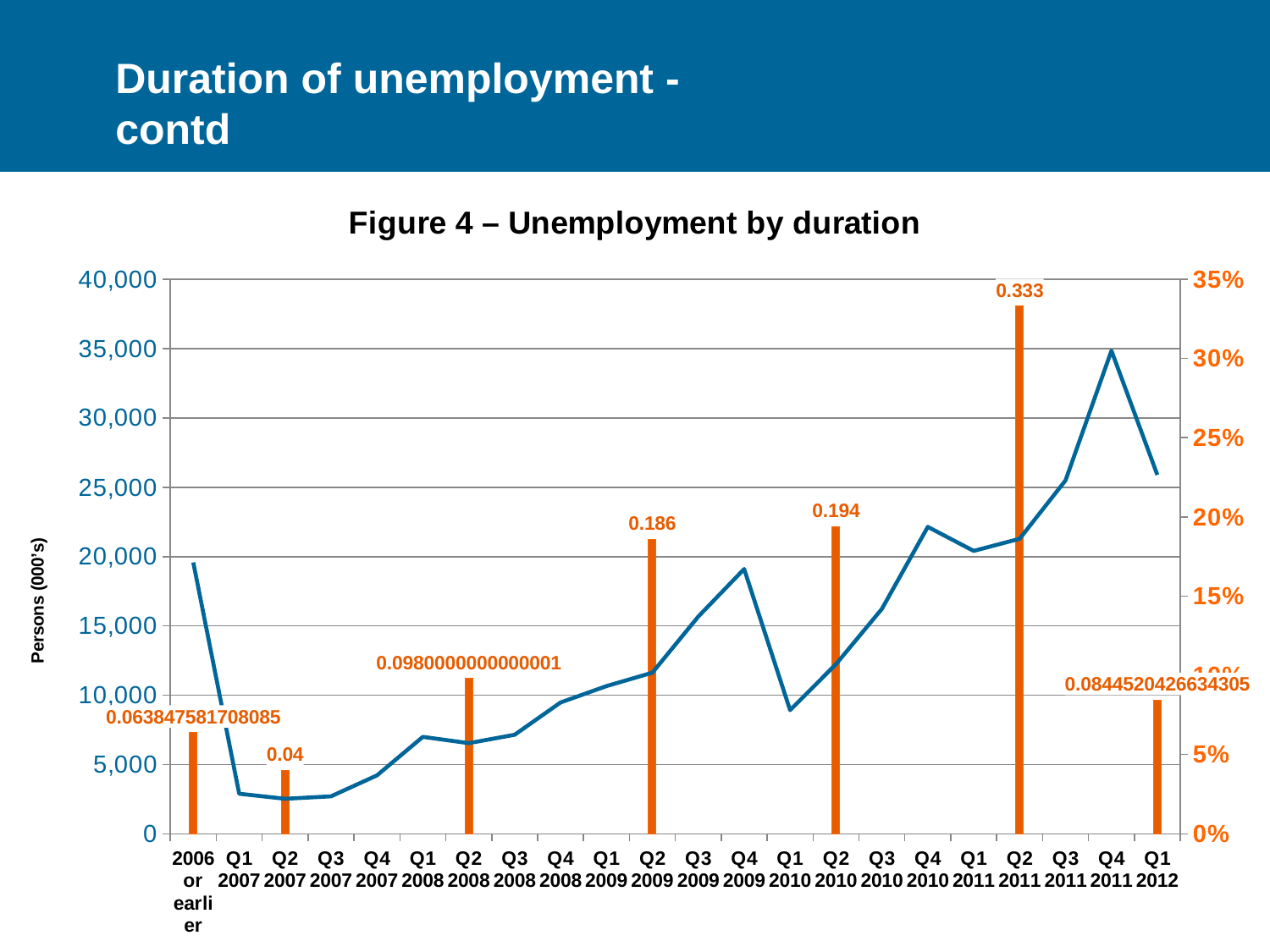
What is the title of the chart? Figure 4 – Unemployment by duration Is the line value for Q4 2011 greater or less than 30,000? greater What value is labelled on the bar for Q2 2007? 0.04 Which period has the shortest bar? Q2 2007 What value is labelled on the bar for Q2 2009? 0.186 What value is labelled on the bar for Q2 2011? 0.333 How many bars are plotted on the chart? 7 Which bar is taller, Q2 2009 or Q2 2010? Q2 2010 Which period has the tallest bar? Q2 2011 What is the difference between the bar values for Q2 2011 and Q2 2010? 0.139 Is the line value for Q1 2010 greater or less than 10,000? less What value is labelled on the bar for Q2 2010? 0.194